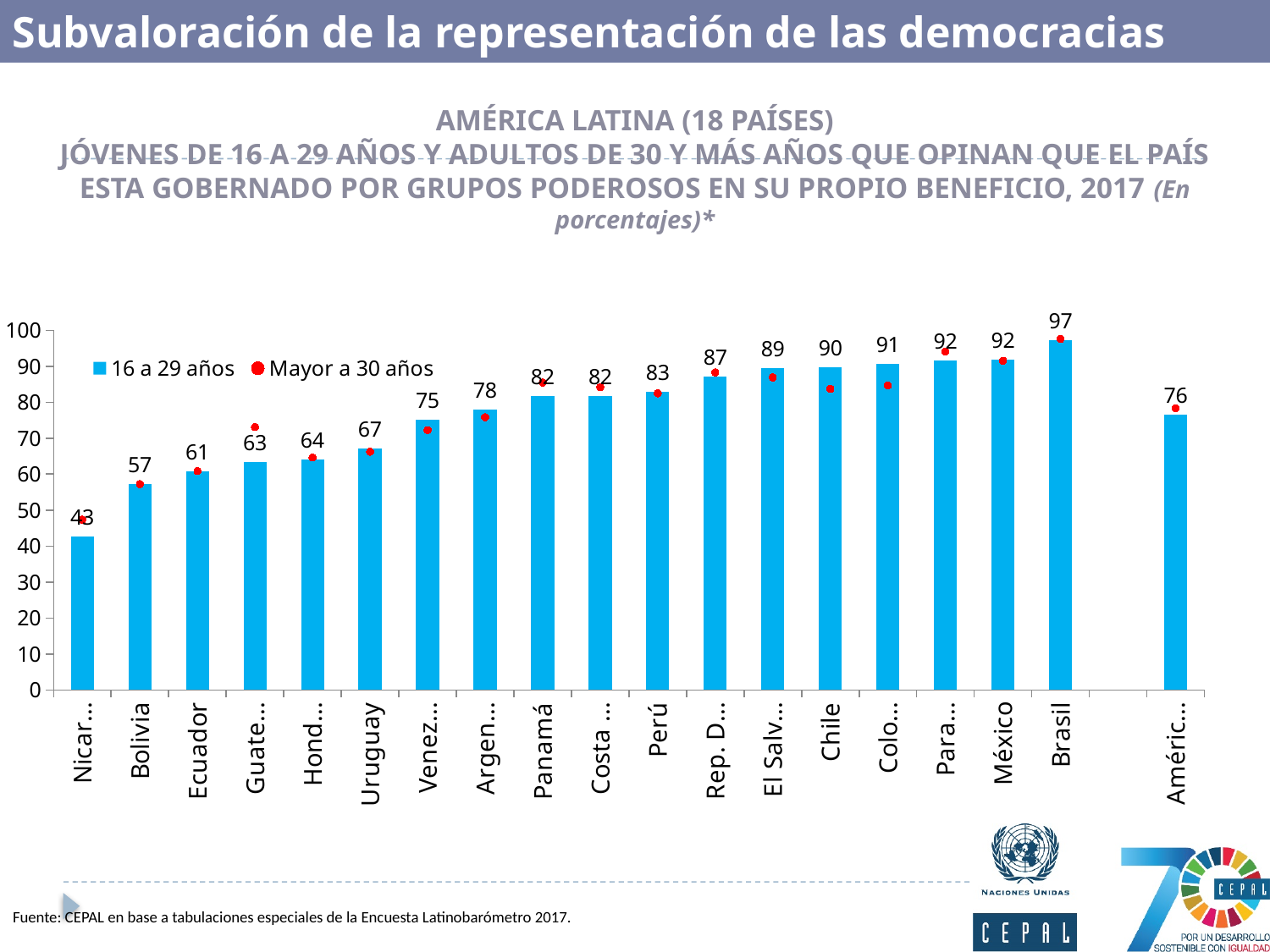
What is the value for Bolivia in the '16 a 29 años' series? 57 Is the 'Mayor a 30 años' value for Chile greater or less than 90? less What is the value for Brasil in the '16 a 29 años' series? 97 What is the value for Uruguay in the '16 a 29 años' series? 67 What kind of chart is shown on the slide? combination bar and line chart (bars with dot markers) What are the two entries in the chart legend? 16 a 29 años; Mayor a 30 años What is the value for México in the '16 a 29 años' series? 92 Which has a higher '16 a 29 años' value, Chile or Perú? Chile What is the value for Panamá in the '16 a 29 años' series? 82 Which country has the highest bar in the '16 a 29 años' series? Brasil What is the difference between the '16 a 29 años' values for Brasil and Bolivia? 40 How many series does the legend list? 2